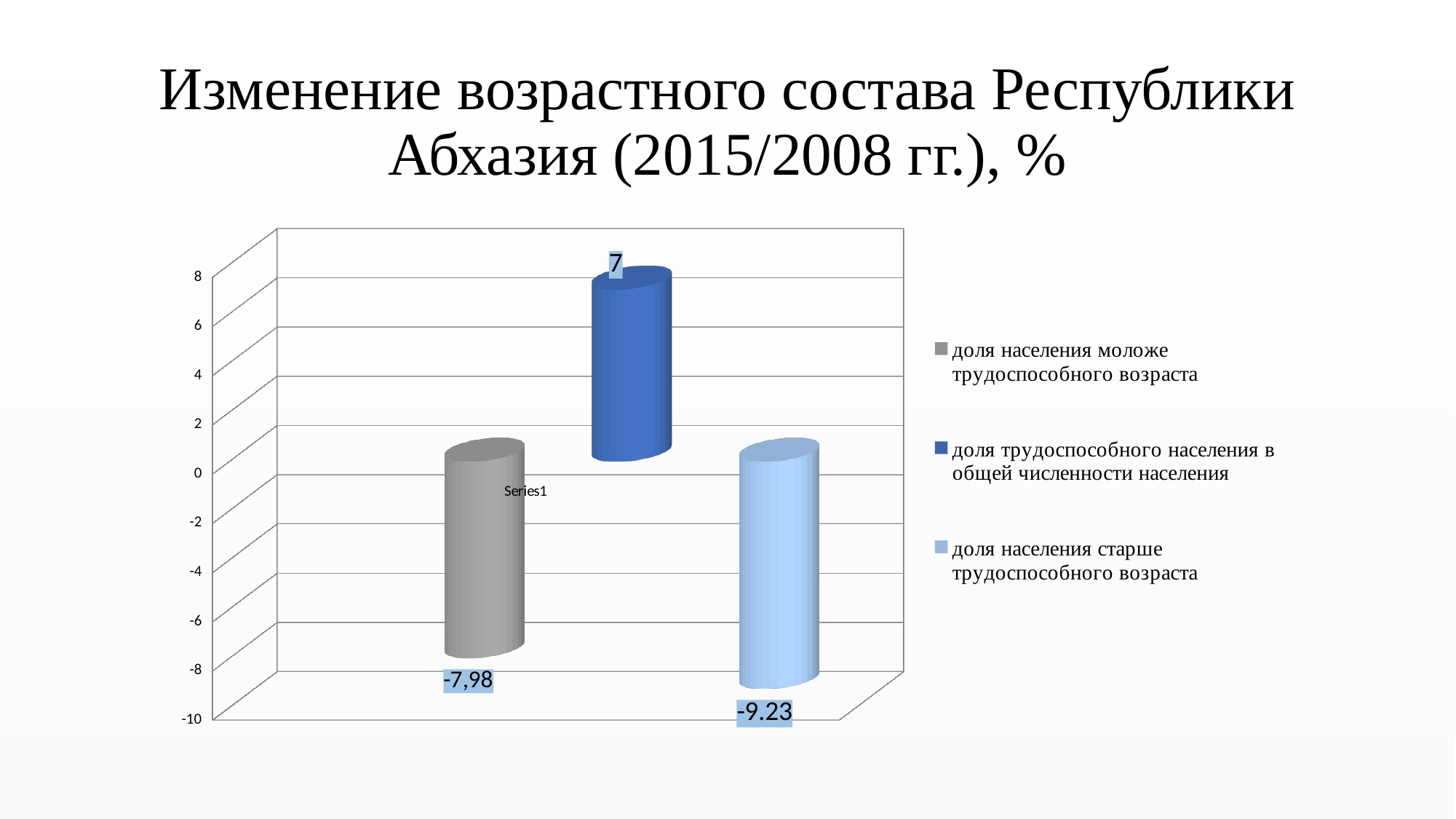
What kind of chart is shown on the slide? bar chart What is the value for доля трудоспособного населения в общей численности населения? 7 How many categories are plotted in the chart? 3 Is the value for доля населения старше трудоспособного возраста greater or less than -8? less Which is larger: the value for доля населения моложе трудоспособного возраста or the value for доля населения старше трудоспособного возраста? доля населения моложе трудоспособного возраста Which category has the highest value? доля трудоспособного населения в общей численности населения What is the value for доля населения старше трудоспособного возраста? -9.23 What is the value for доля населения моложе трудоспособного возраста? -7,98 Which category has the lowest value? доля населения старше трудоспособного возраста What is the difference between the value for доля трудоспособного населения в общей численности населения and the value for доля населения старше трудоспособного возраста? 16.23 What is the difference between the value for доля населения моложе трудоспособного возраста and the value for доля населения старше трудоспособного возраста? 1.25 What is the title of the chart? Изменение возрастного состава Республики Абхазия (2015/2008 гг.), %